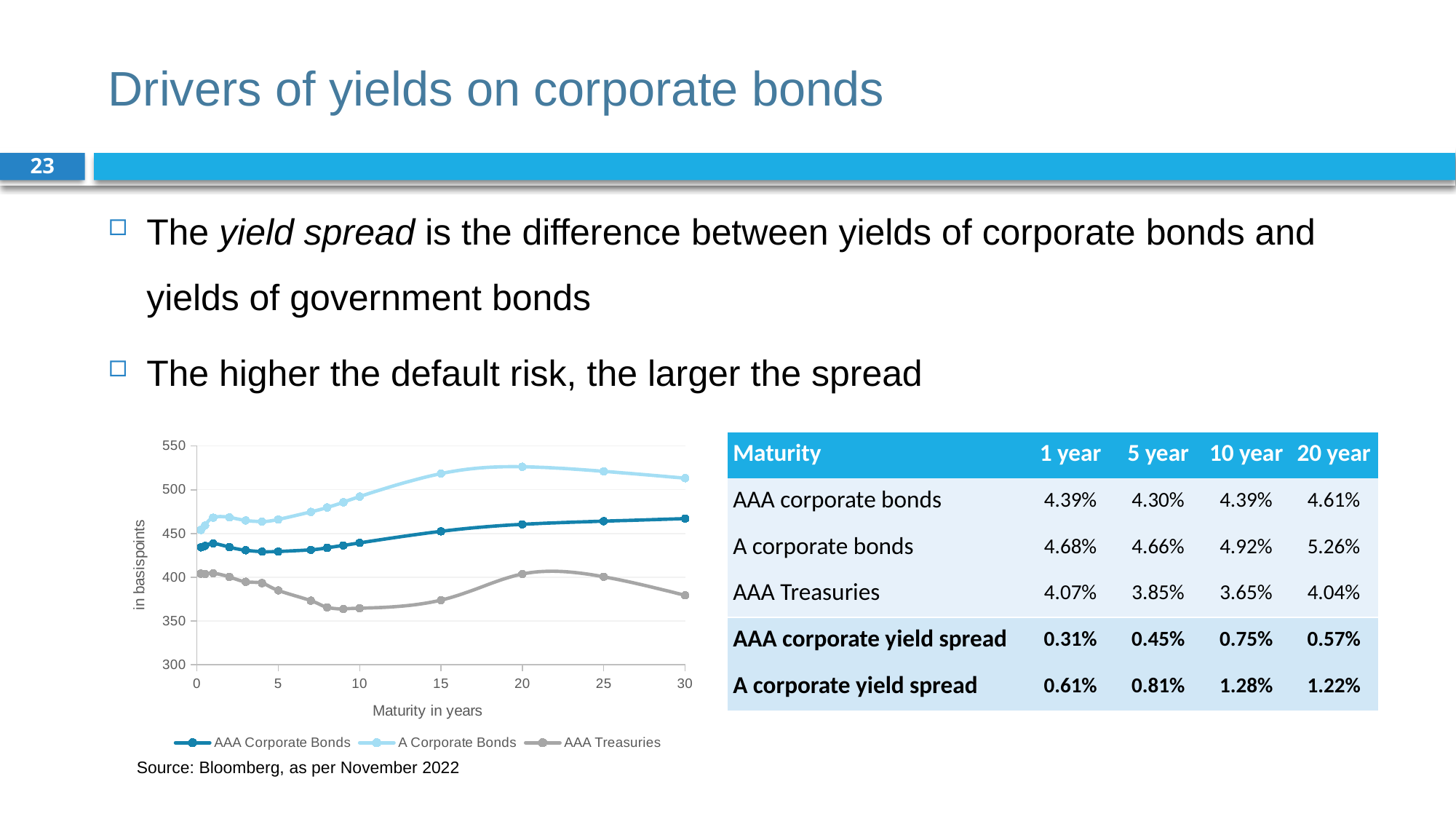
Is the value for AAA Corporate Bonds at a maturity of 5 years greater or less than 450? less Is the value for A Corporate Bonds at a maturity of 20 years greater or less than 500? greater Which series has the highest values across the chart? A Corporate Bonds At a maturity of 20 years, which series has the higher value: A Corporate Bonds or AAA Treasuries? A Corporate Bonds What is the label of the chart's horizontal axis? Maturity in years Is the value for AAA Treasuries at a maturity of 10 years greater or less than 400? less Does the A Corporate Bonds line rise or fall between maturities of 10 and 20 years? rise What kind of chart is shown on the slide? line chart How many series does the chart legend list? 3 What is the label of the chart's vertical axis? in basispoints Which series has the lowest values across the chart? AAA Treasuries